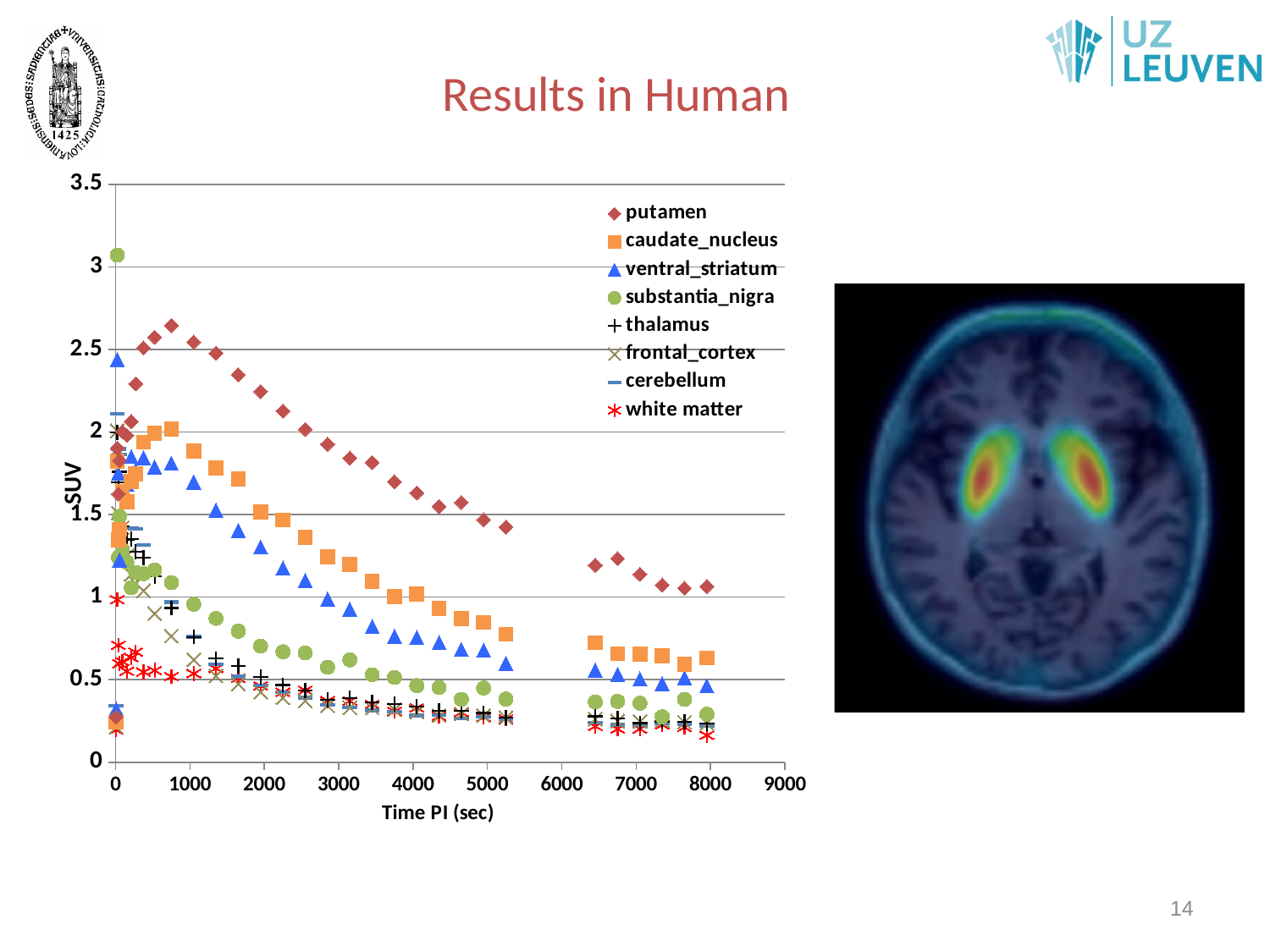
What is the title of the y axis? SUV At around 4000 sec, which is larger: the putamen value or the caudate_nucleus value? putamen What kind of chart is shown on the slide? scatter chart Is the peak value of the putamen series greater or less than 2.5? greater Is the putamen value at around 8000 sec greater or less than 1.5? less After about 1000 sec, does the putamen series rise or fall as time increases? fall Which series has the highest SUV at around 8000 sec? putamen What is the title of the x axis? Time PI (sec) Is the white matter value at around 8000 sec greater or less than 0.5? less How many series does the legend list? 8